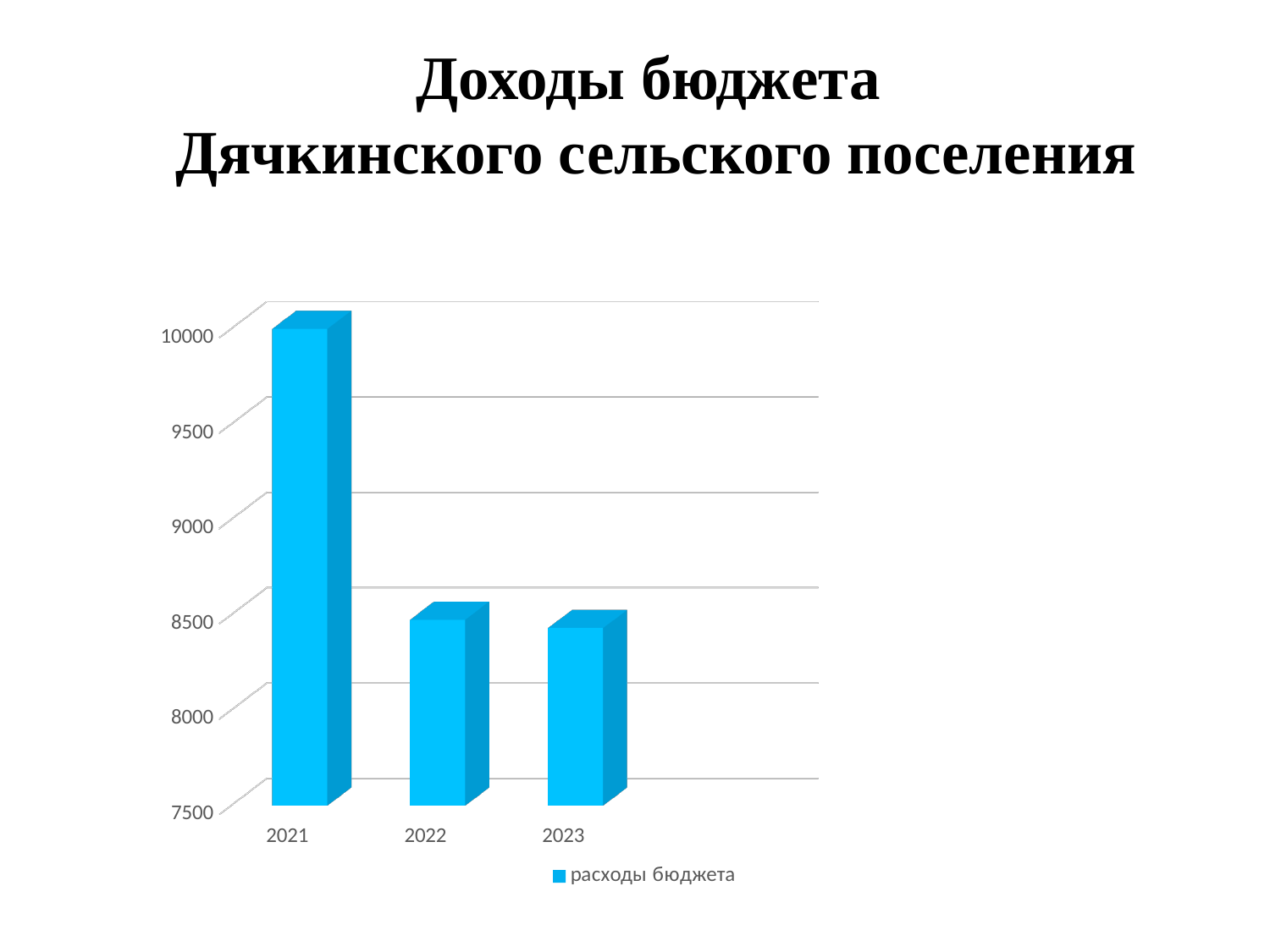
What is the title of the slide? Доходы бюджета Дячкинского сельского поселения Is the value for 2021 greater or less than 9500? greater Which year has the highest value? 2021 How many series does the legend list? 1 Is the value for 2022 greater or less than 9000? less How many years (categories) are shown on the x axis? 3 What series name is shown in the legend? расходы бюджета Do the values rise or fall from 2021 to 2023? fall What kind of chart is shown on the slide? bar chart Which is larger, the value for 2021 or the value for 2023? 2021 Is the value for 2022 greater or less than 8000? greater